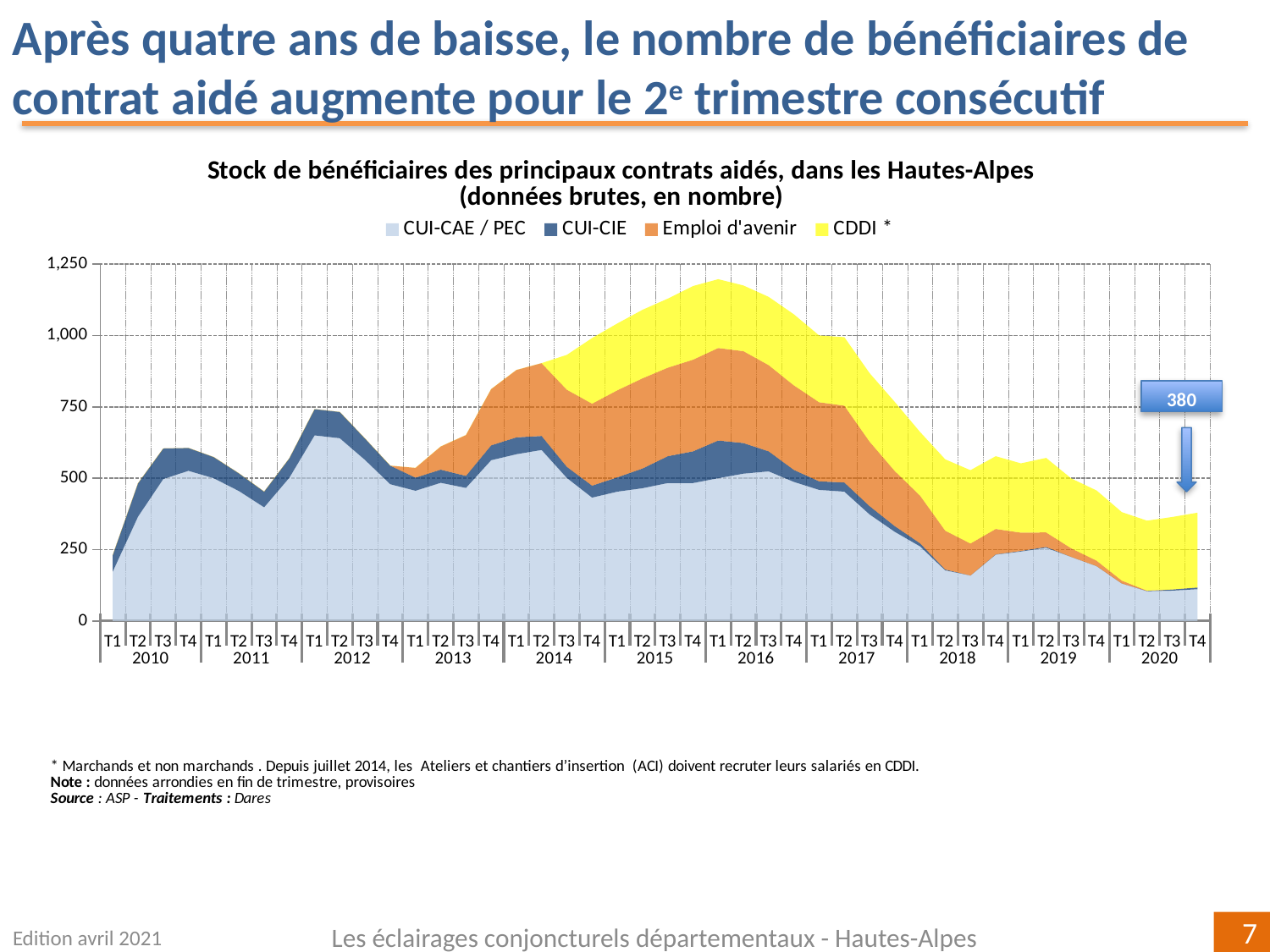
What is the title of the chart? Stock de bénéficiaires des principaux contrats aidés, dans les Hautes-Alpes (données brutes, en nombre) Is the total stock of beneficiaries at T1 2012 greater or less than 500? greater Is the total stock of beneficiaries at T1 2016 greater or less than 1,000? greater In which quarter does the total stock of beneficiaries reach its highest level? T1 2016 How many years are shown on the x axis? 11 Does the total stock of beneficiaries rise or fall between T1 2016 and T2 2020? Fall Is the total stock of beneficiaries at T2 2020 greater or less than 500? less What is the total stock of beneficiaries labelled for T4 2020? 380 What kind of chart is shown on the slide? Stacked area chart How many series does the legend list? 4 Which series is shown in yellow? CDDI *